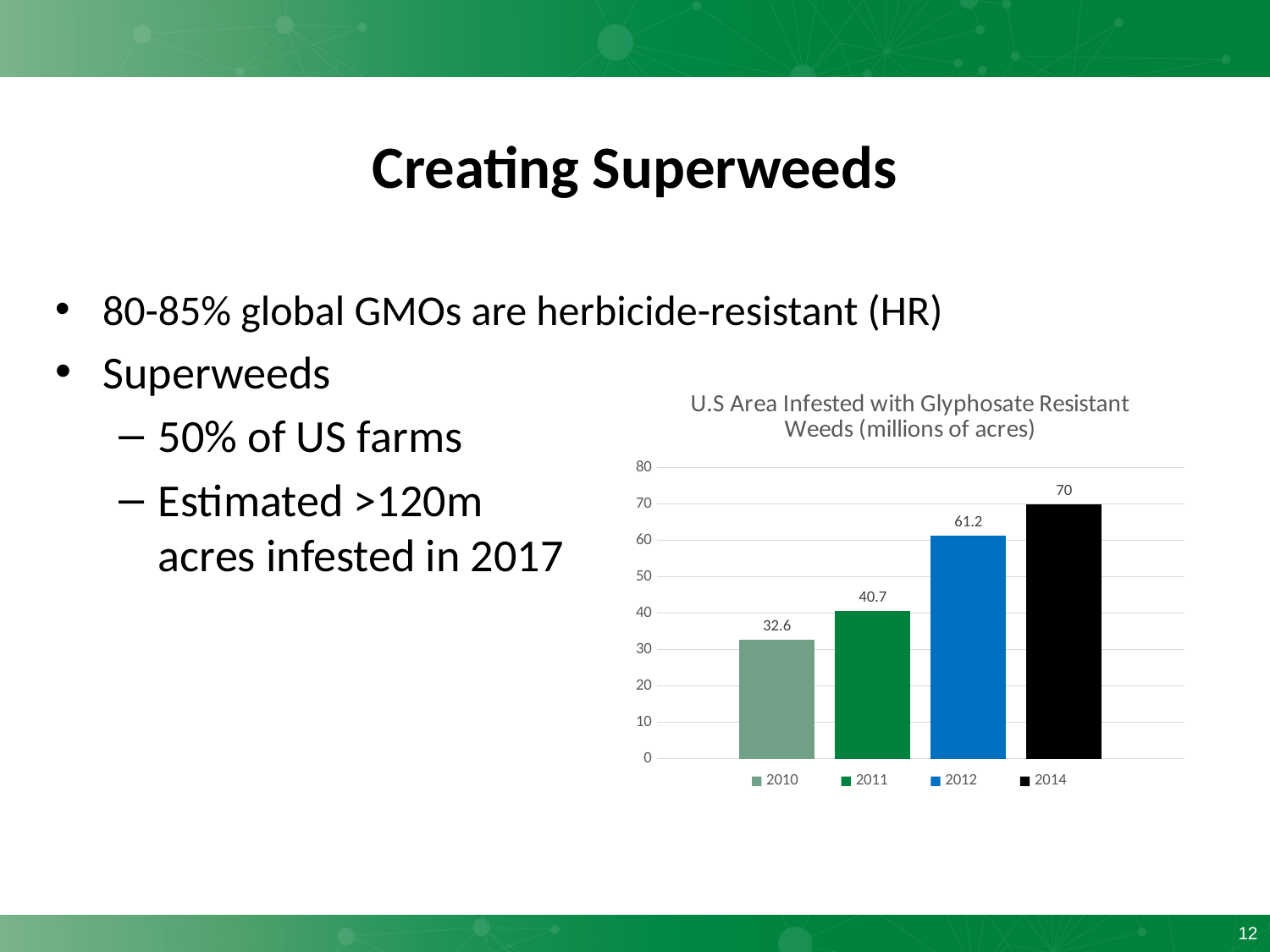
Which year has the lowest value in the chart? 2010 What kind of chart is shown on the slide? bar chart What is the difference between the values for 2012 and 2011? 20.5 How many years are shown in the chart? 4 Which is larger, the value for 2011 or the value for 2012? 2012 Do the values rise or fall from 2010 to 2014? rise What is the value for 2010 in the chart? 32.6 Which year has the highest value in the chart? 2014 What is the value for 2014 in the chart? 70 Is the value for 2011 greater or less than 50? less What is the difference between the values for 2014 and 2010? 37.4 What is the value for 2012 in the chart? 61.2